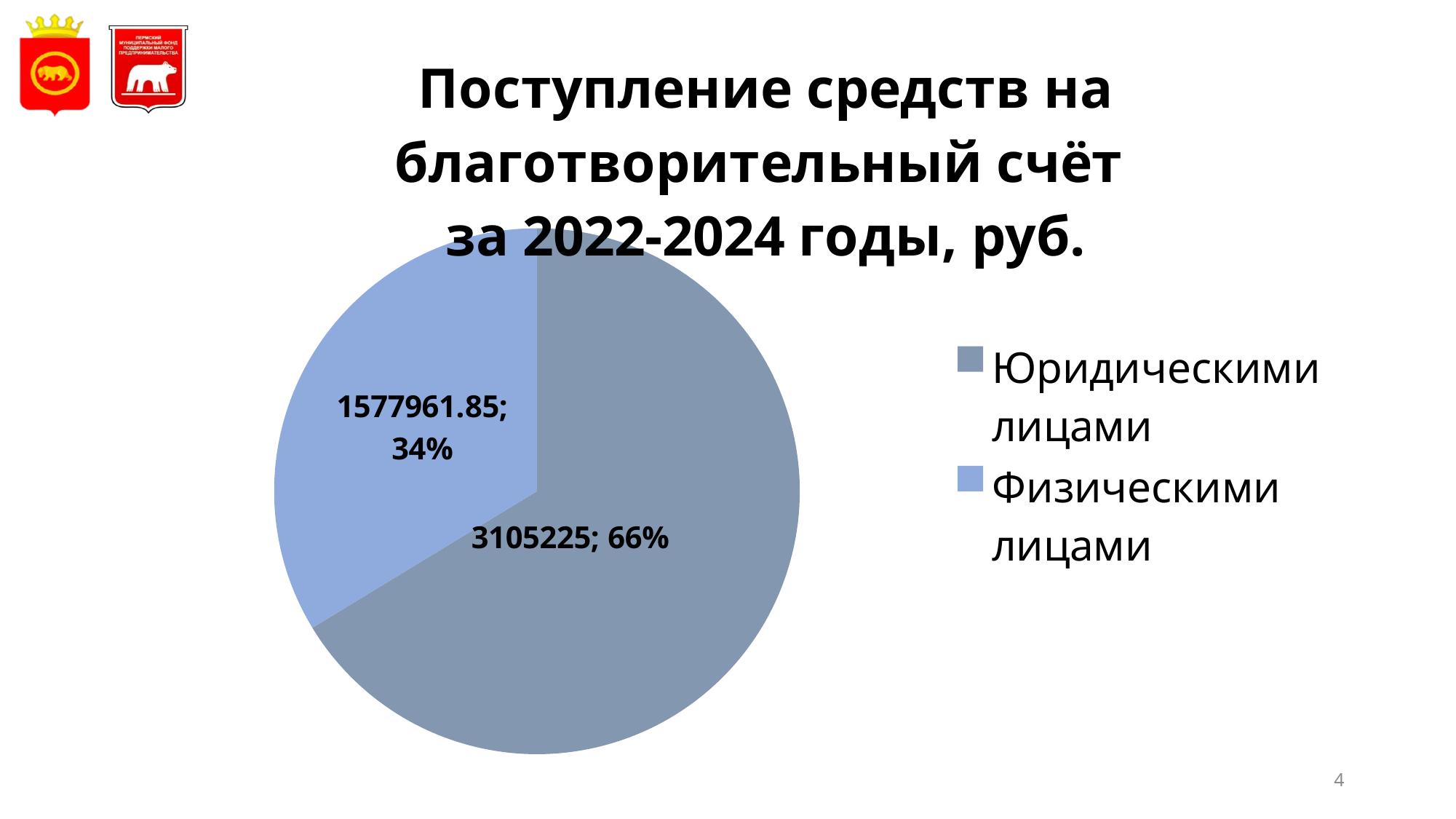
How many slices does the pie chart have? 2 What share of the pie does Юридическими лицами represent? 66% Which category has the smallest slice? Физическими лицами Which is larger: the value for Юридическими лицами or for Физическими лицами? Юридическими лицами What is the value for Юридическими лицами? 3105225 What kind of chart is shown on the slide? pie chart How many entries does the legend list? 2 What is the difference between the values for Юридическими лицами and Физическими лицами? 1527263.15 Which category has the largest slice? Юридическими лицами What share of the pie does Физическими лицами represent? 34% What is the title of the chart? Поступление средств на благотворительный счёт за 2022-2024 годы, руб. What is the value for Физическими лицами? 1577961.85